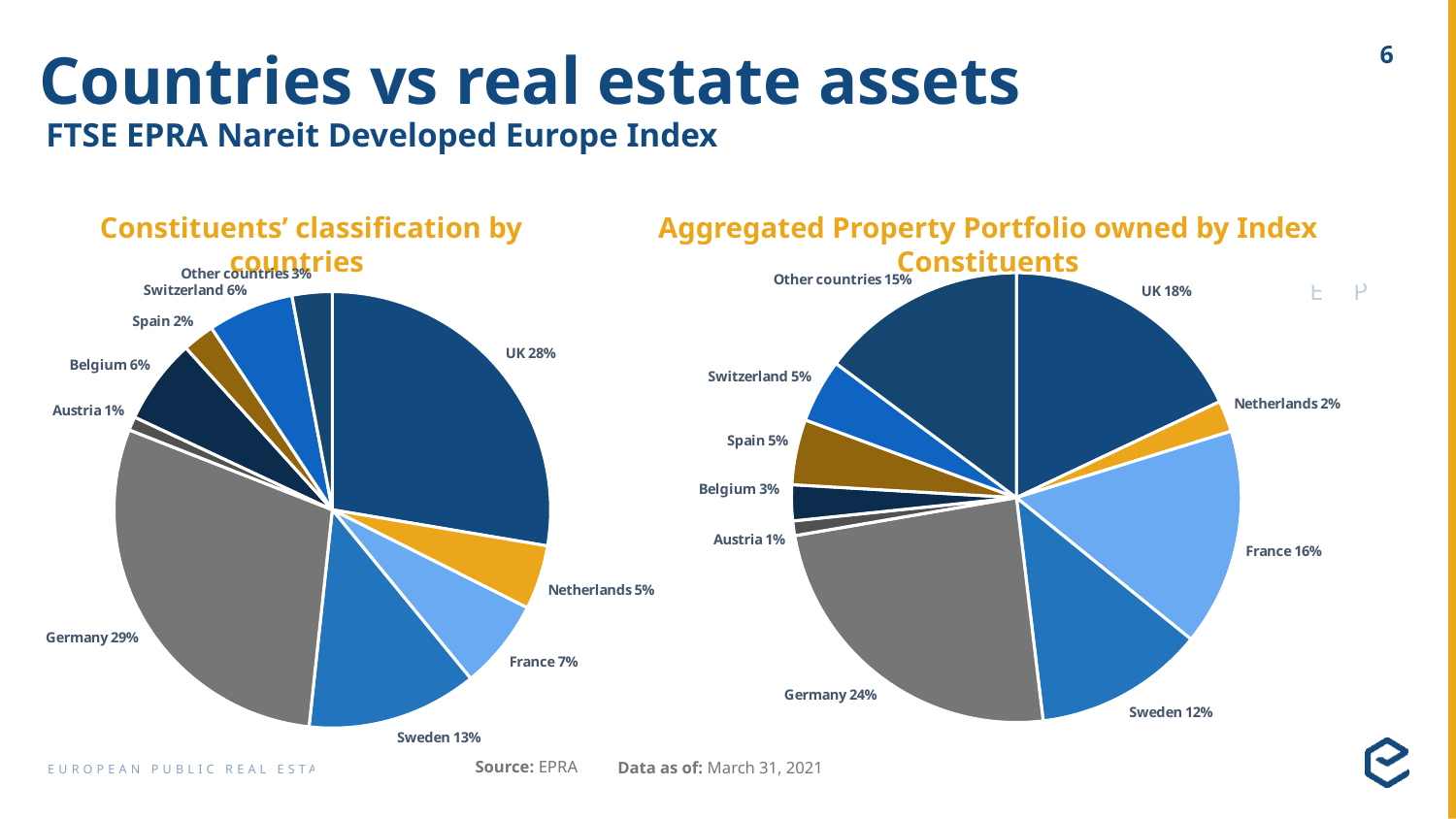
In the 'Aggregated Property Portfolio owned by Index Constituents' pie chart, what is the difference between the UK's share and Sweden's share? 6% In the 'Aggregated Property Portfolio owned by Index Constituents' pie chart, which is larger: the share for Spain or the share for Belgium? Spain In the 'Constituents' classification by countries' pie chart, which country has the largest share? Germany In the 'Constituents' classification by countries' pie chart, what share does Netherlands have? 5% In the 'Aggregated Property Portfolio owned by Index Constituents' pie chart, what share do Other countries have? 15% In the 'Constituents' classification by countries' pie chart, what is the difference between Germany's share and Sweden's share? 16% What is the title of the pie chart on the left of the slide? Constituents' classification by countries In the 'Aggregated Property Portfolio owned by Index Constituents' pie chart, which country has the smallest share? Austria What type of chart is the 'Aggregated Property Portfolio owned by Index Constituents' chart? Pie chart How many categories are shown in the 'Constituents' classification by countries' pie chart? 10 In the 'Aggregated Property Portfolio owned by Index Constituents' pie chart, what share does France have? 16% In the 'Constituents' classification by countries' pie chart, what share does the UK have? 28%